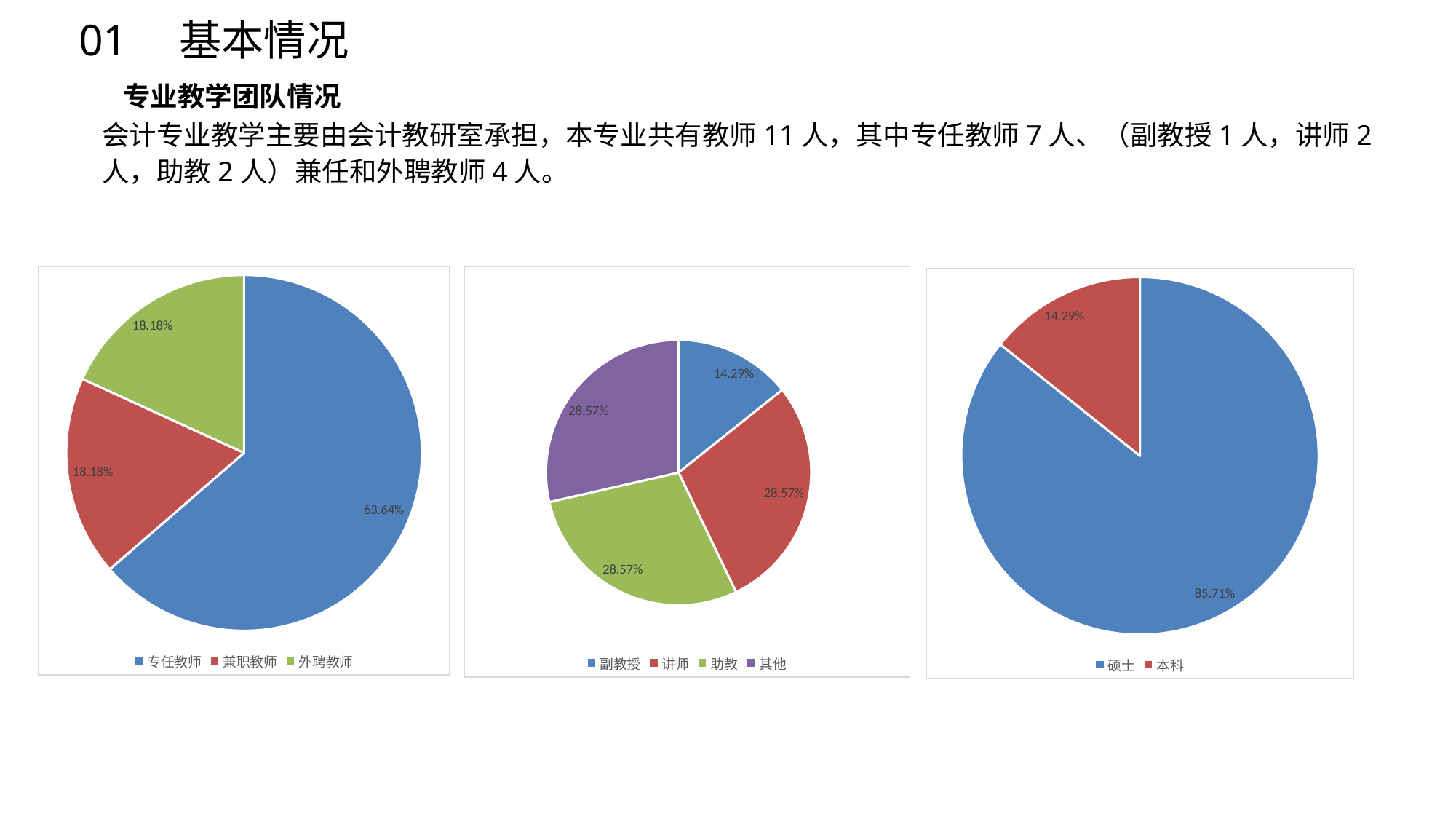
What type of chart is the right chart? Pie chart In the left pie chart, what share does 兼职教师 have? 18.18% In the middle pie chart, what share does 副教授 have? 14.29% In the middle pie chart, what share does 讲师 have? 28.57% In the middle pie chart, which category has the smallest slice? 副教授 In the left pie chart, which category has the largest slice? 专任教师 How many slices does the left pie chart have? 3 How many categories does the legend of the middle pie chart list? 4 In the middle pie chart, what is the difference between the shares of 助教 and 副教授? 14.28% In the right pie chart, which is larger, 硕士 or 本科? 硕士